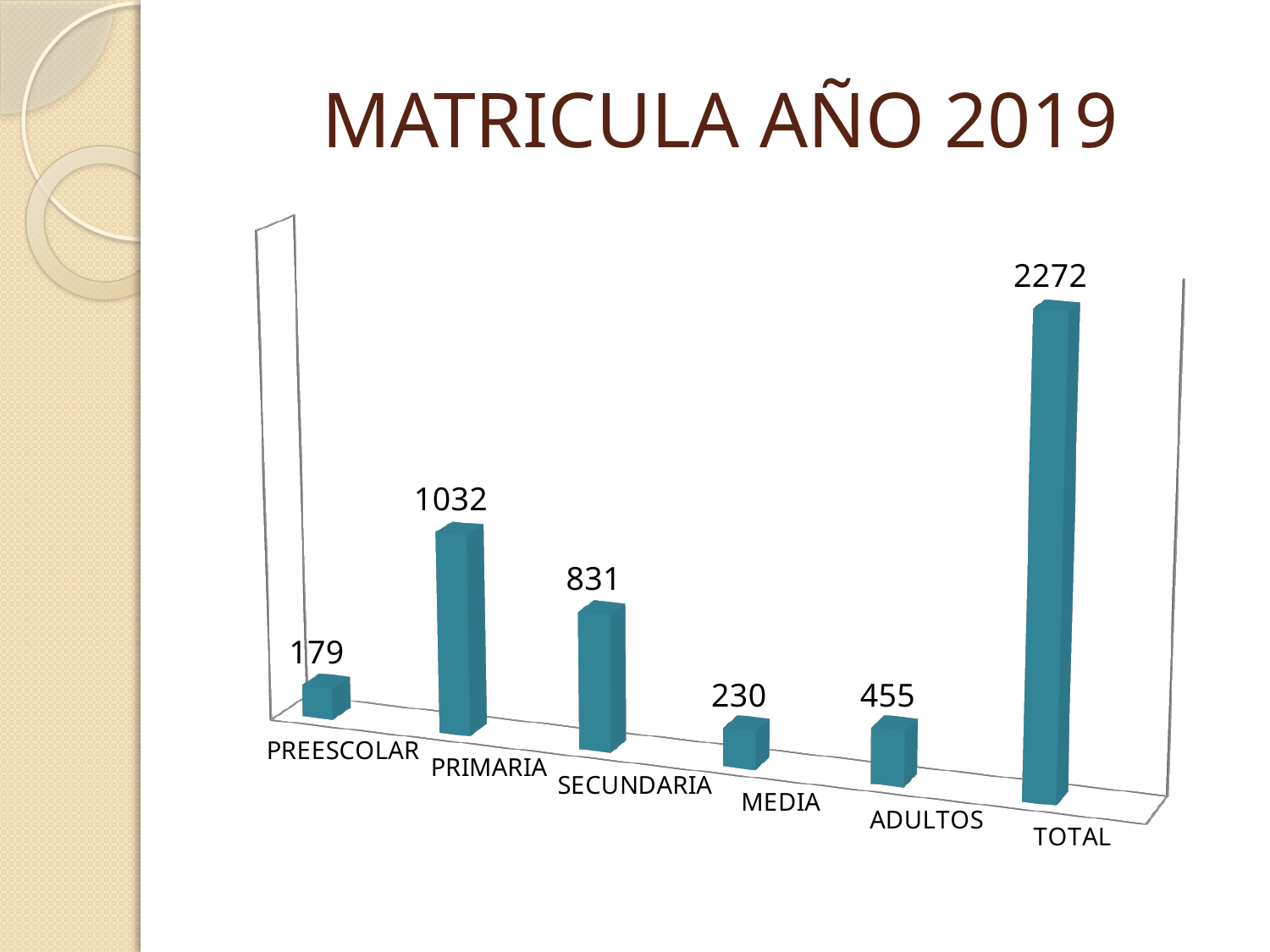
What is the value for SECUNDARIA? 831 What is the title of the chart? MATRICULA AÑO 2019 Which is larger, the value for MEDIA or the value for ADULTOS? ADULTOS How many categories are shown on the chart? 6 What is the value for ADULTOS? 455 What is the value for TOTAL? 2272 What is the value for PREESCOLAR? 179 What kind of chart is shown on the slide? Bar chart Which category has the highest value? TOTAL What is the difference between the values for PRIMARIA and SECUNDARIA? 201 Which category has the lowest value? PREESCOLAR What is the value for PRIMARIA? 1032